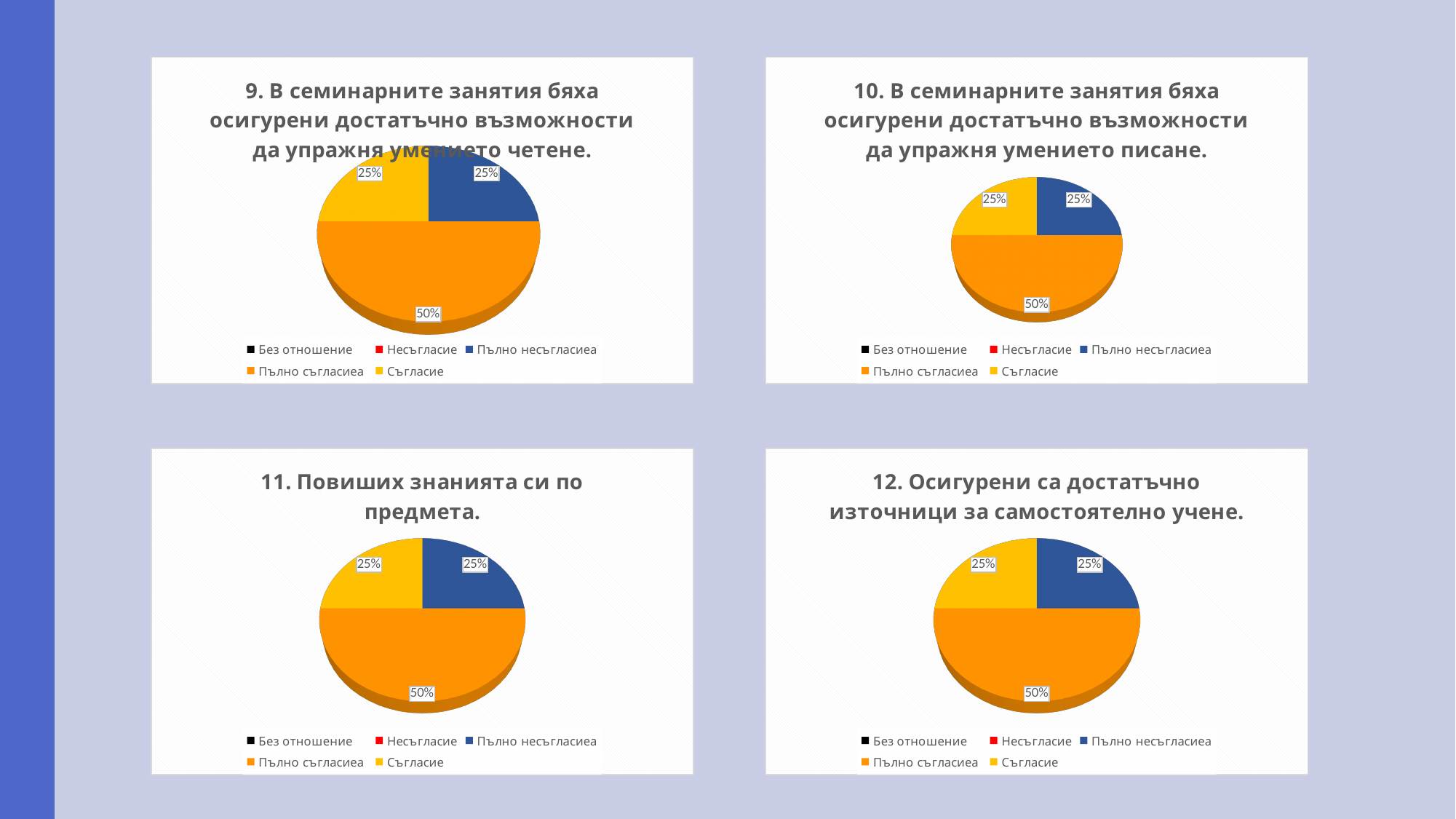
In the top-right chart (question 10), what is the difference between the "Пълно съгласиеа" slice and the "Съгласие" slice? 25% In the top-left chart (question 9), what share of the pie is labelled for "Пълно съгласиеа" (orange)? 50% What colour represents "Съгласие" in the legend of the bottom-right chart (question 12)? yellow In the top-right chart (question 10), what percentage is shown for the "Съгласие" (yellow) slice? 25% In the bottom-left chart (question 11), which is larger: the "Пълно съгласиеа" slice or the "Пълно несъгласиеа" slice? Пълно съгласиеа What is the title of the bottom-right chart? 12. Осигурени са достатъчно източници за самостоятелно учене. In the bottom-left chart titled "11. Повиших знанията си по предмета.", which legend category has the largest slice? Пълно съгласиеа In the top-left chart (question 9), what is the combined share of the "Пълно несъгласиеа" and "Съгласие" slices? 50% In the bottom-right chart (question 12), what percentage is shown for the "Пълно несъгласиеа" (blue) slice? 25% How many entries does the legend list in the top-left chart (question 9)? 5 In the bottom-right chart (question 12), how many slices are visible in the pie? 3 What kind of chart is used in the top-left chart titled "9. В семинарните занятия бяха осигурени достатъчно възможности да упражня умението четене."? pie chart